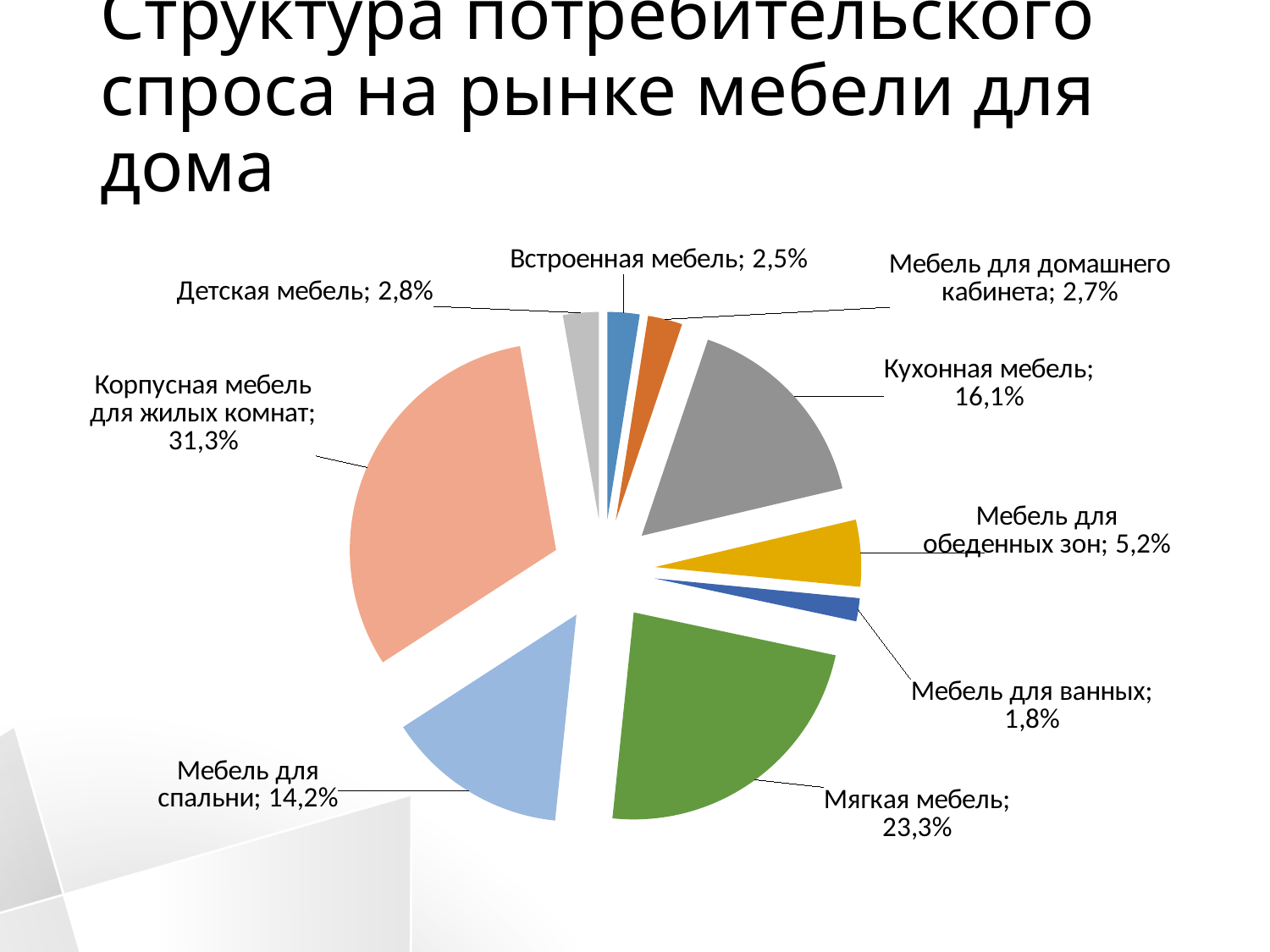
Which is larger: the share of Детская мебель or the share of Мебель для домашнего кабинета? Детская мебель How many categories (slices) does the pie chart contain? 9 What percentage is shown for Кухонная мебель? 16,1% What is the difference between the shares of Мягкая мебель and Мебель для спальни? 9,1% What is the value for Мебель для ванных? 1,8% Which category has the largest share of the pie? Корпусная мебель для жилых комнат What type of chart is shown on the slide? pie chart Which category has the smallest share of the pie? Мебель для ванных What is the value shown for Мягкая мебель? 23,3% What share of consumer demand does Корпусная мебель для жилых комнат account for? 31,3% What is the difference between the shares of Корпусная мебель для жилых комнат and Кухонная мебель? 15,2% What is the title of the chart on the slide? Структура потребительского спроса на рынке мебели для дома